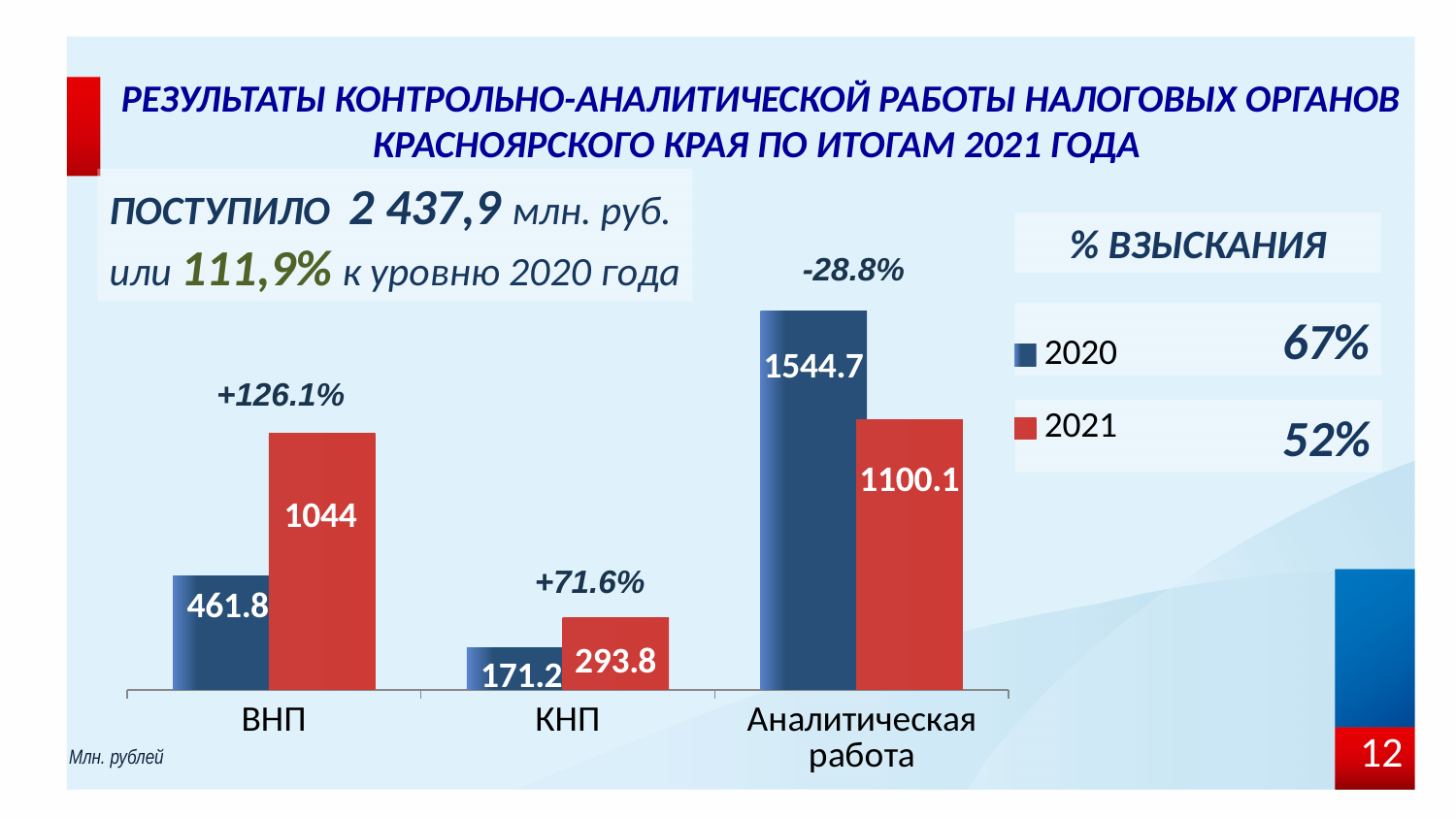
What is the 2021 value for Аналитическая работа? 1100.1 What is the difference between the 2021 and 2020 values for ВНП? 582.2 What percentage change is labelled above the КНП bars? +71.6% How many series does the legend list? 2 What kind of chart is shown on the slide? Bar chart What is the 2021 value for ВНП? 1044 How many categories are shown on the x axis of the chart? 3 What is the 2020 value for Аналитическая работа? 1544.7 Which is larger for Аналитическая работа: the 2020 value or the 2021 value? 2020 What is the 2020 value for КНП? 171.2 Which category has the lowest 2021 value? КНП Which category has the highest 2020 value? Аналитическая работа